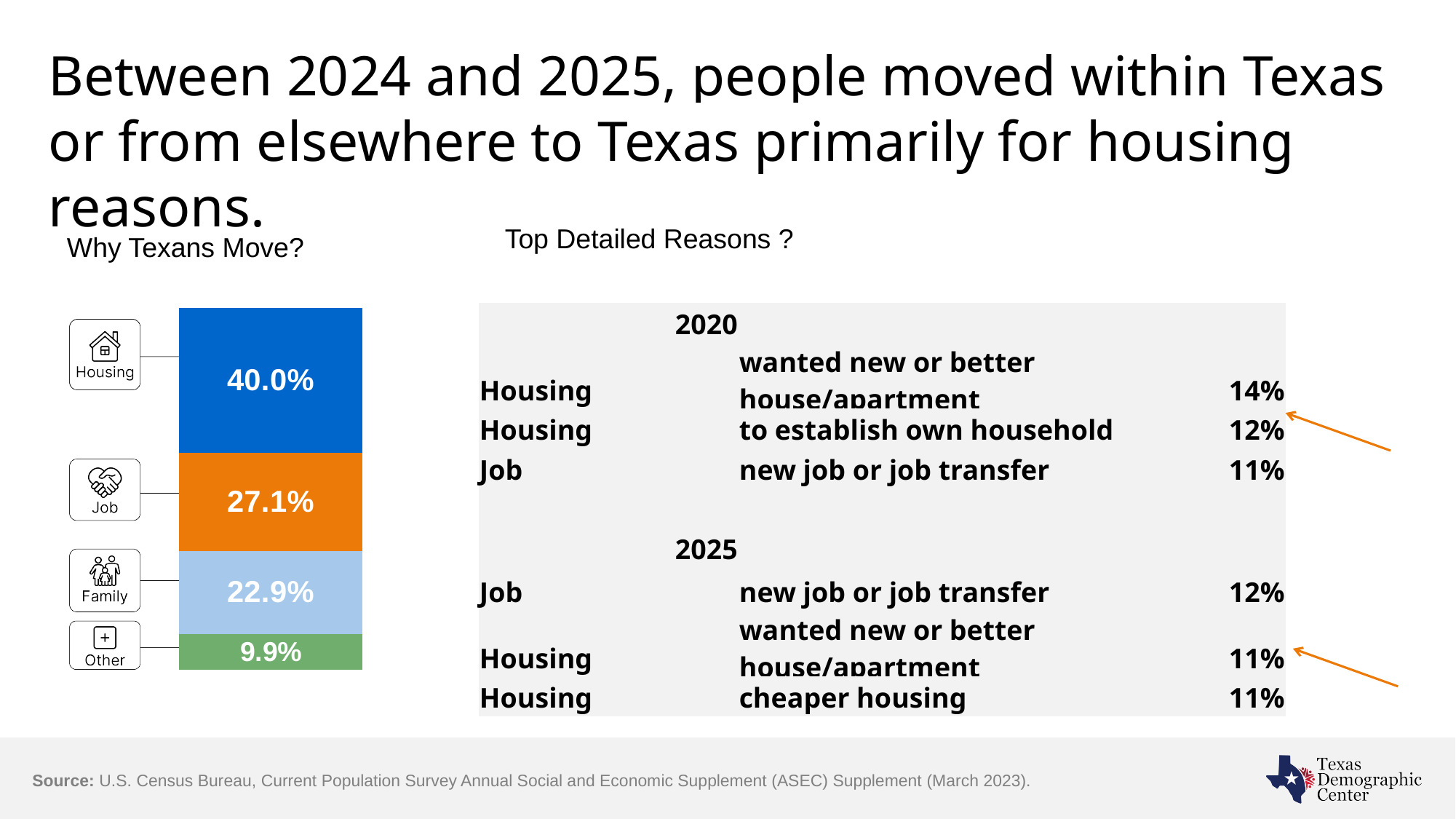
In the 'Why Texans Move?' chart, what colour is the Job segment? Orange In the 'Why Texans Move?' chart, which is larger, the share for Family or the share for Other? Family What type of chart is the 'Why Texans Move?' chart? Stacked bar chart In the 'Why Texans Move?' chart, what is the difference in percentage points between Housing and Job? 12.9 In the 'Why Texans Move?' chart, which reason has the smallest share? Other In the 'Why Texans Move?' chart, what percentage of moves is attributed to Job? 27.1% In the 'Why Texans Move?' chart, what percentage of moves is attributed to Housing? 40.0% In the 'Why Texans Move?' chart, what percentage of moves is attributed to Other? 9.9% How many reason categories are shown in the 'Why Texans Move?' chart? 4 In the 'Why Texans Move?' chart, which reason has the largest share? Housing In the 'Why Texans Move?' chart, what percentage of moves is attributed to Family? 22.9% In the 'Why Texans Move?' chart, what is the difference in percentage points between Job and Family? 4.2